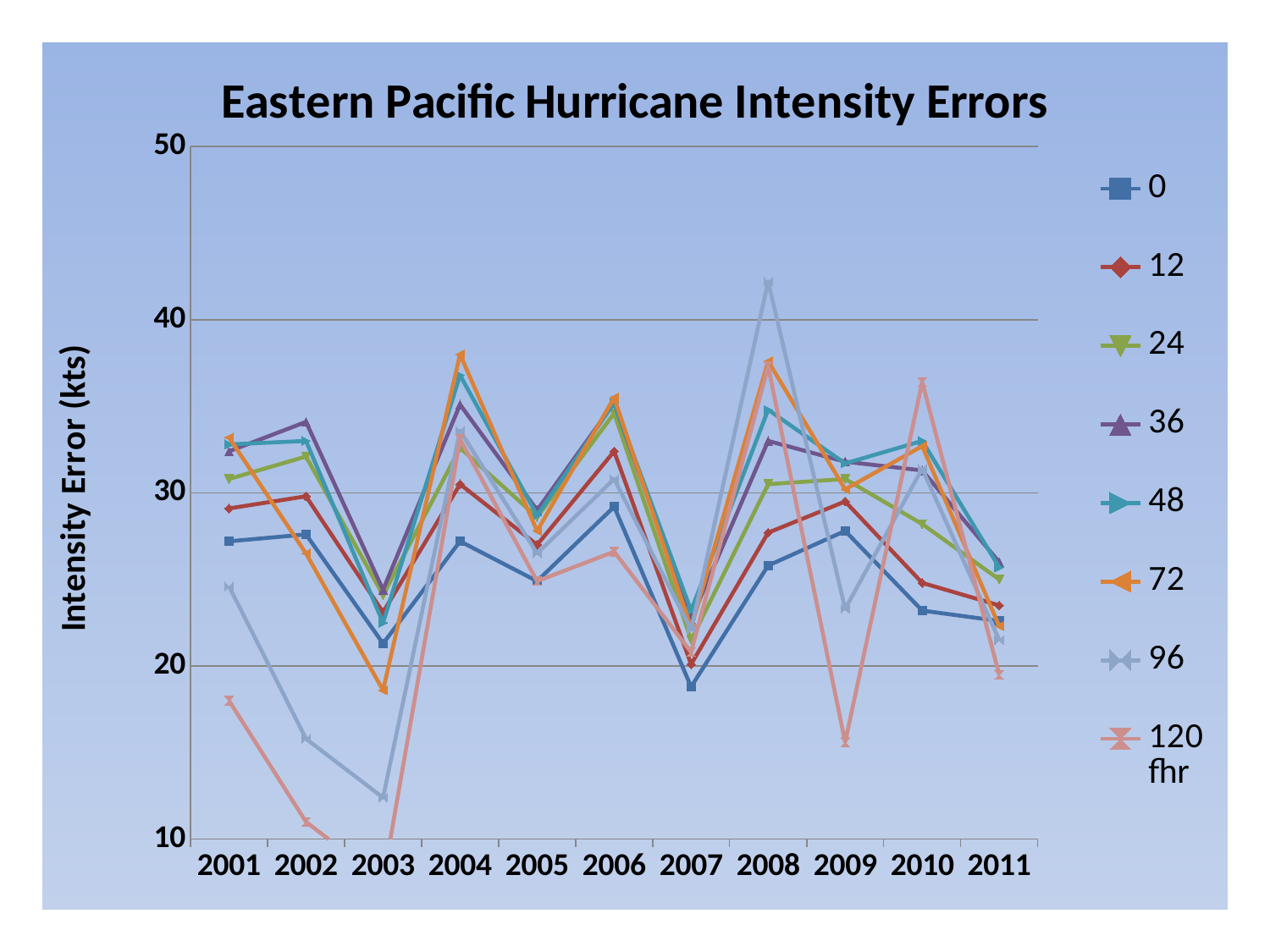
In which year does the 0 series reach its lowest value? 2007 Is the value for the 0 series in 2007 greater or less than 20? less In which year does the 96 series reach its highest value? 2008 Is the value for the 96 series in 2008 greater or less than 40? greater What is the label of the vertical axis? Intensity Error (kts) How many series does the legend list? 8 Is the value for the 120 fhr series in 2009 greater or less than 20? less What is the title of the chart? Eastern Pacific Hurricane Intensity Errors Does the 96 series rise or fall from 2001 to 2003? fall What kind of chart is shown on the slide? line chart How many years are shown along the x axis? 11 In 2010, which series has the larger value, 120 fhr or 0? 120 fhr